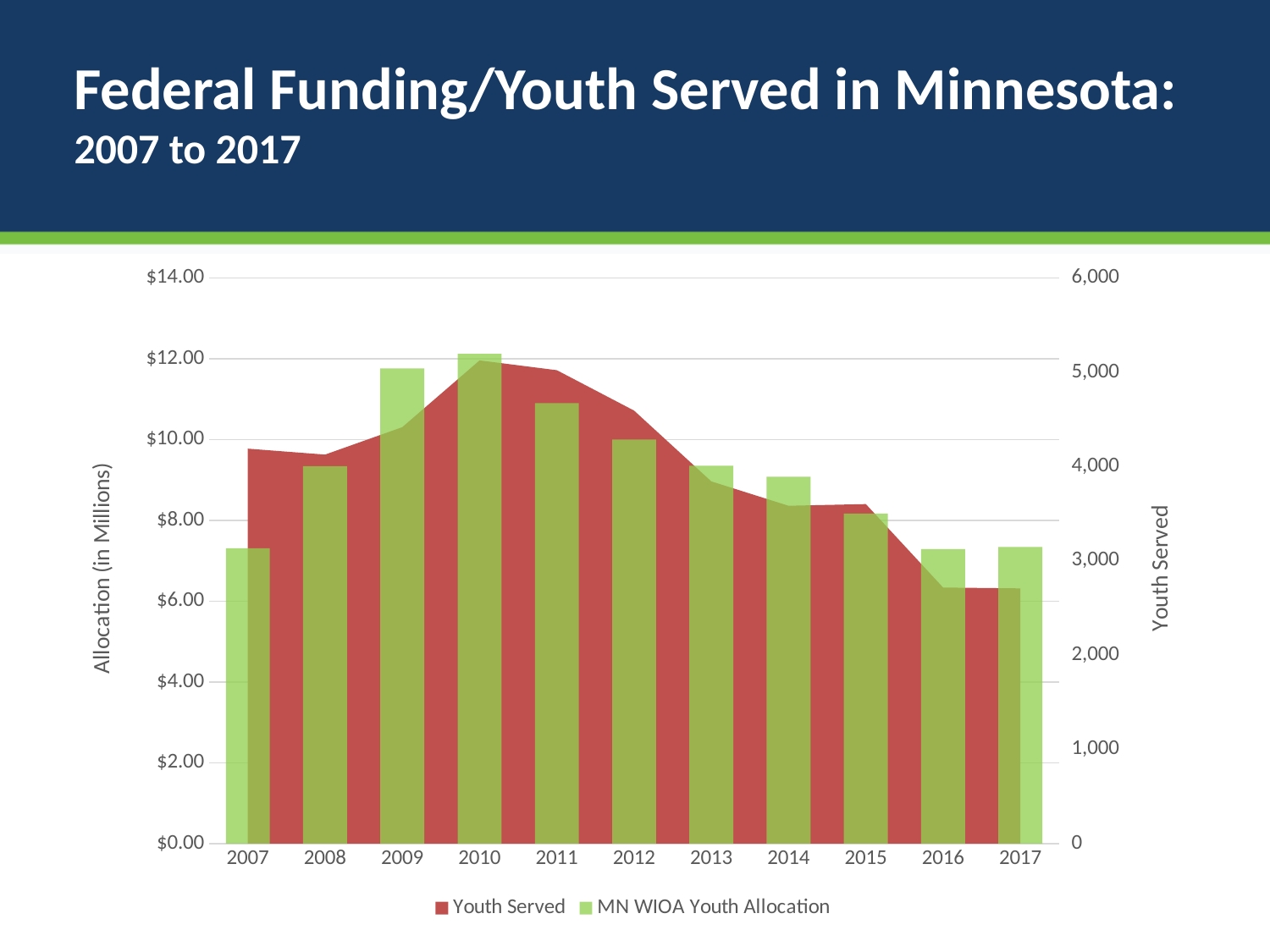
Which year has a larger MN WIOA Youth Allocation, 2008 or 2009? 2009 Does the number of Youth Served rise or fall from 2010 to 2017? fall Is the MN WIOA Youth Allocation for 2013 greater or less than $10.00? less What is the label on the left vertical axis of the chart? Allocation (in Millions) How many series does the chart's legend list? 2 What kind of chart is shown on the slide? A combination of a bar chart and an area chart Is the MN WIOA Youth Allocation for 2007 greater or less than $8.00? less How many years are shown along the x axis of the chart? 11 Is the number of Youth Served in 2016 greater or less than 3,000? less Which year has the highest MN WIOA Youth Allocation? 2010